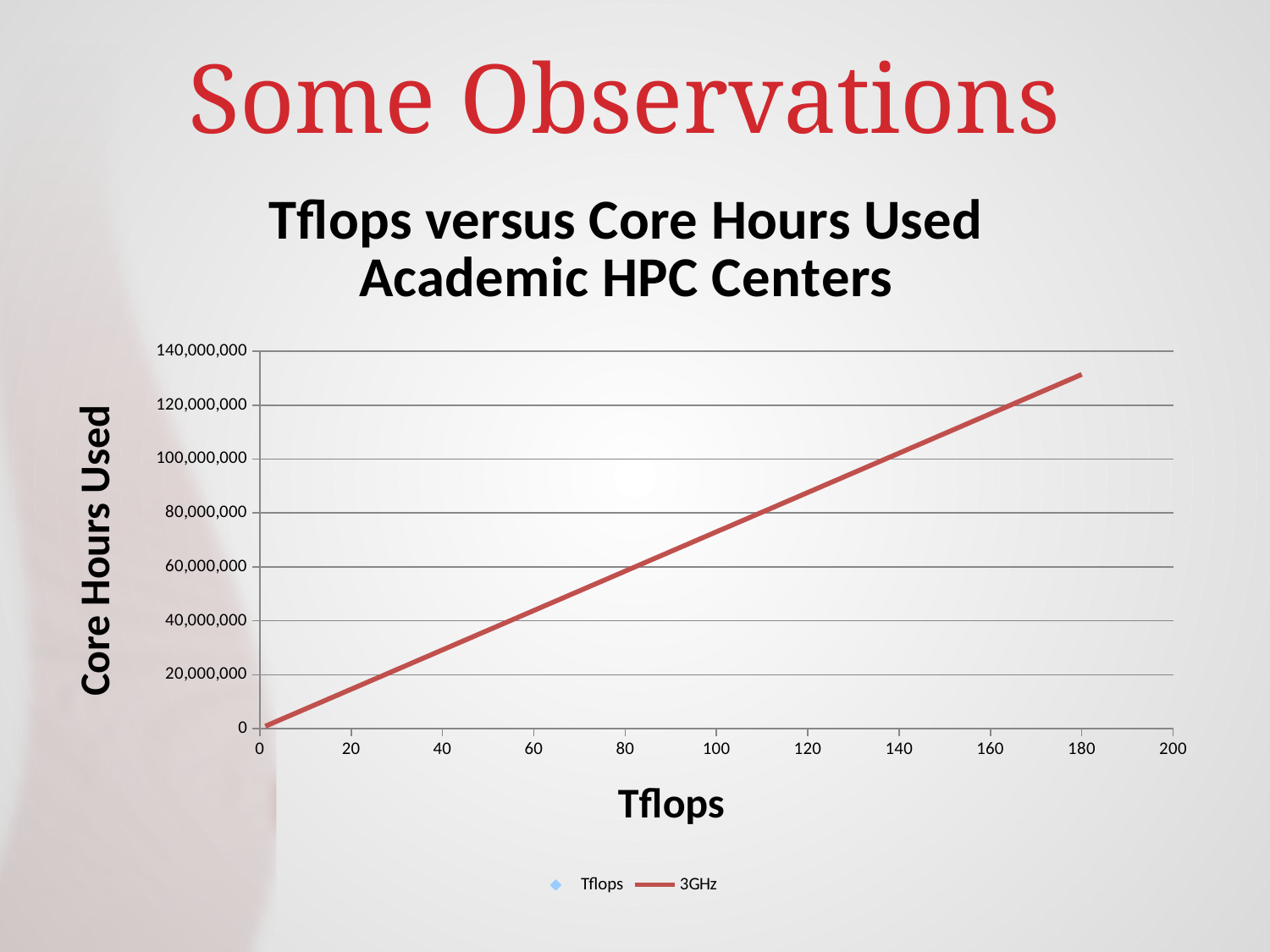
What kind of chart is shown on the slide? line chart Is the value of the 3GHz line at 160 Tflops greater or less than 100,000,000 core hours? greater How many entries does the chart legend list? 2 Do the core hours used rise or fall as Tflops increase along the x axis? rise Is the value of the 3GHz line at 40 Tflops greater or less than 40,000,000 core hours? less What is the label of the vertical axis? Core Hours Used What is the title of the chart? Tflops versus Core Hours Used Academic HPC Centers Is the value of the 3GHz line at 180 Tflops greater or less than 120,000,000 core hours? greater Which is larger on the 3GHz line: the core hours used at 60 Tflops or at 140 Tflops? 140 Tflops